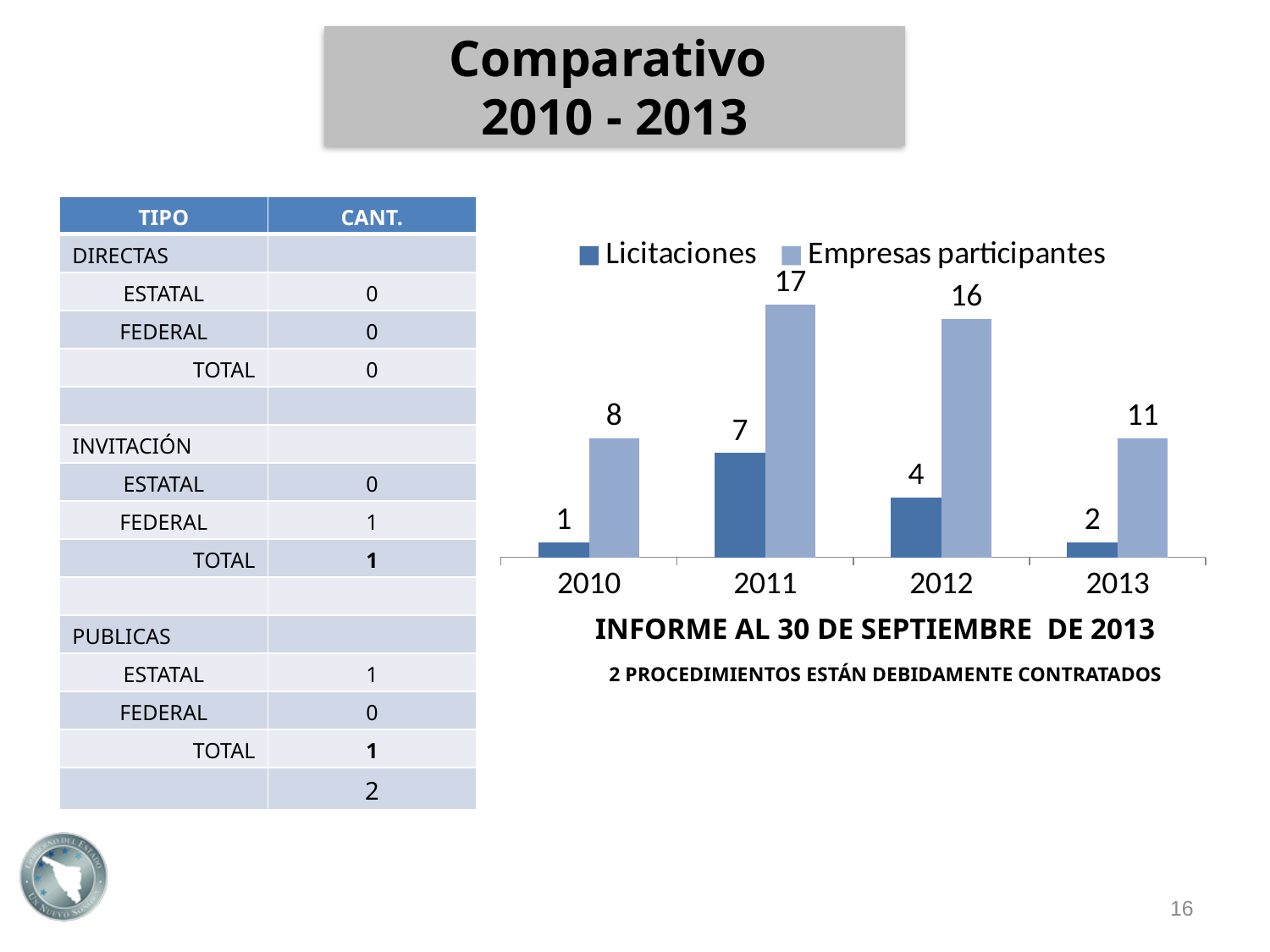
How many years are shown on the x axis of the chart? 4 How many series does the chart legend list? 2 What is the value of Empresas participantes for 2013? 11 What are the two series named in the chart legend? Licitaciones and Empresas participantes Which year has the highest value for Empresas participantes? 2011 What is the value of Licitaciones for 2011? 7 Which is larger, Licitaciones in 2011 or Licitaciones in 2013? Licitaciones in 2011 Which year has the lowest value for Licitaciones? 2010 What is the value of Licitaciones for 2010? 1 What is the difference between Empresas participantes in 2011 and 2012? 1 What kind of chart is shown on the slide? Bar chart What is the difference between Licitaciones and Empresas participantes in 2012? 12